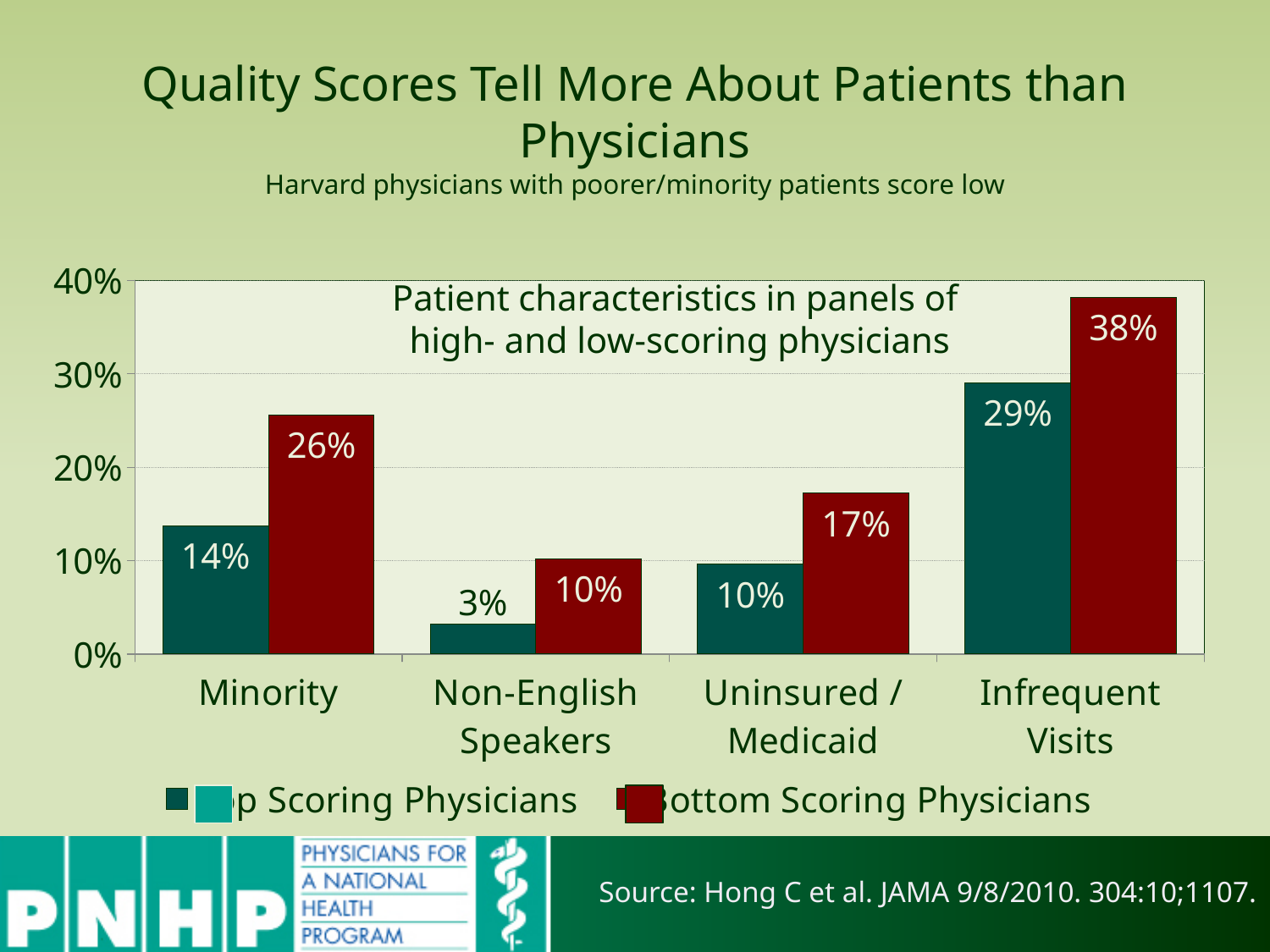
How many categories are shown on the x axis? 4 What is the value for Top Scoring Physicians in the Non-English Speakers category? 3% Which category has the lowest value for Top Scoring Physicians? Non-English Speakers Which category has the highest value for Bottom Scoring Physicians? Infrequent Visits What is the value for Top Scoring Physicians in the Minority category? 14% What kind of chart is shown on the slide? Bar chart What is the title of the chart? Patient characteristics in panels of high- and low-scoring physicians What is the value for Bottom Scoring Physicians in the Infrequent Visits category? 38% What is the difference between the Bottom Scoring Physicians and Top Scoring Physicians values in the Minority category? 12% In the Uninsured / Medicaid category, which series has the larger value, Top Scoring Physicians or Bottom Scoring Physicians? Bottom Scoring Physicians What is the value for Bottom Scoring Physicians in the Uninsured / Medicaid category? 17% How many series does the legend list? 2